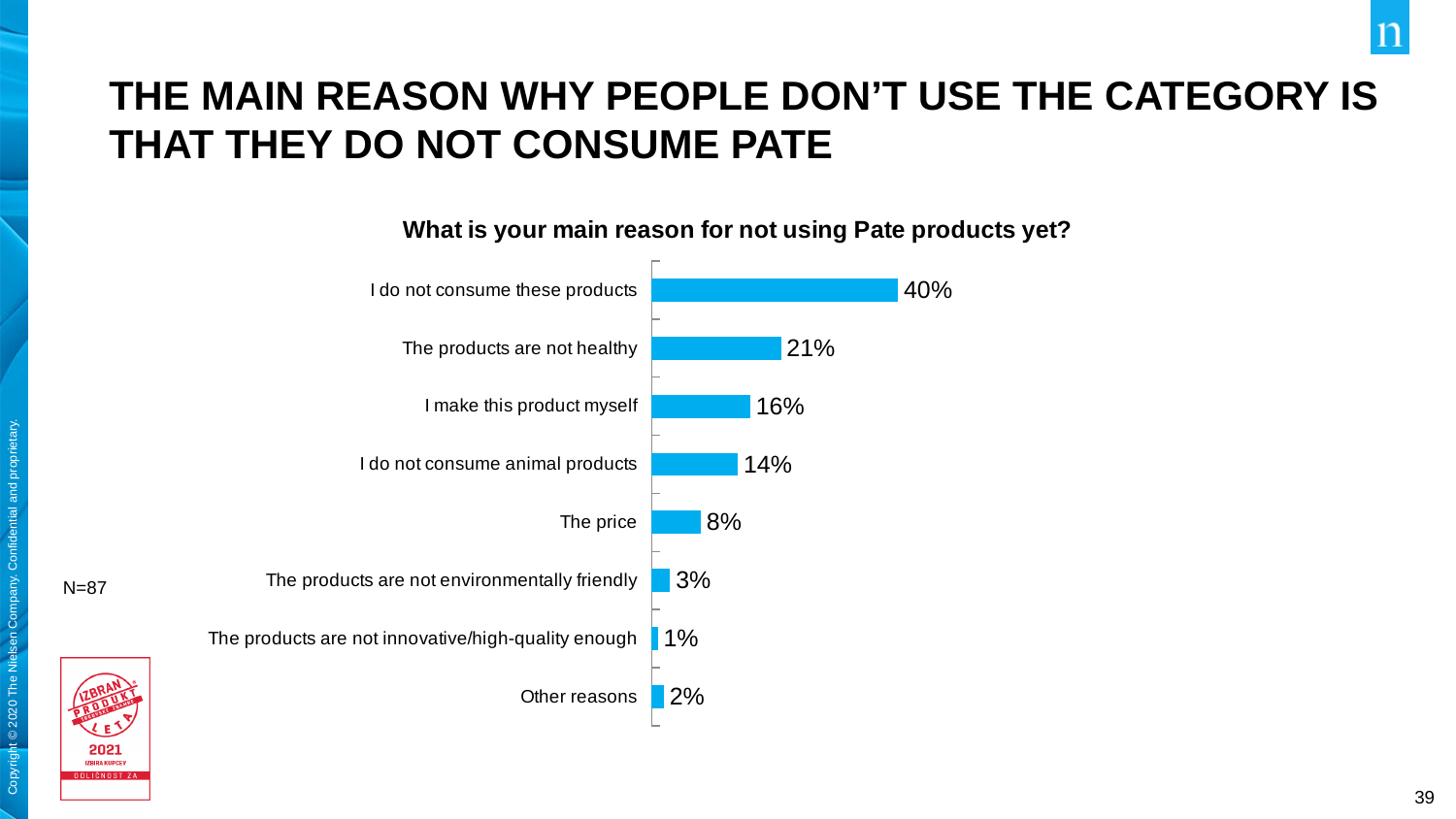
What question is the chart titled with? What is your main reason for not using Pate products yet? Which is larger: the value for "I make this product myself" or the value for "I do not consume animal products"? I make this product myself What percentage of respondents said "I do not consume these products" as their main reason for not using Pate products? 40% What type of chart is used on this slide? Bar chart What is the difference in percentage points between "I do not consume these products" and "The products are not healthy"? 19 How many reasons (categories) are shown in the chart? 8 What percentage is shown for "I make this product myself"? 16% Which reason has the lowest percentage in the chart? The products are not innovative/high-quality enough What is the value shown for "The products are not healthy"? 21% Which reason has the highest percentage in the chart? I do not consume these products What is the sample size (N) stated on the slide? N=87 What is the value for "The price"? 8%